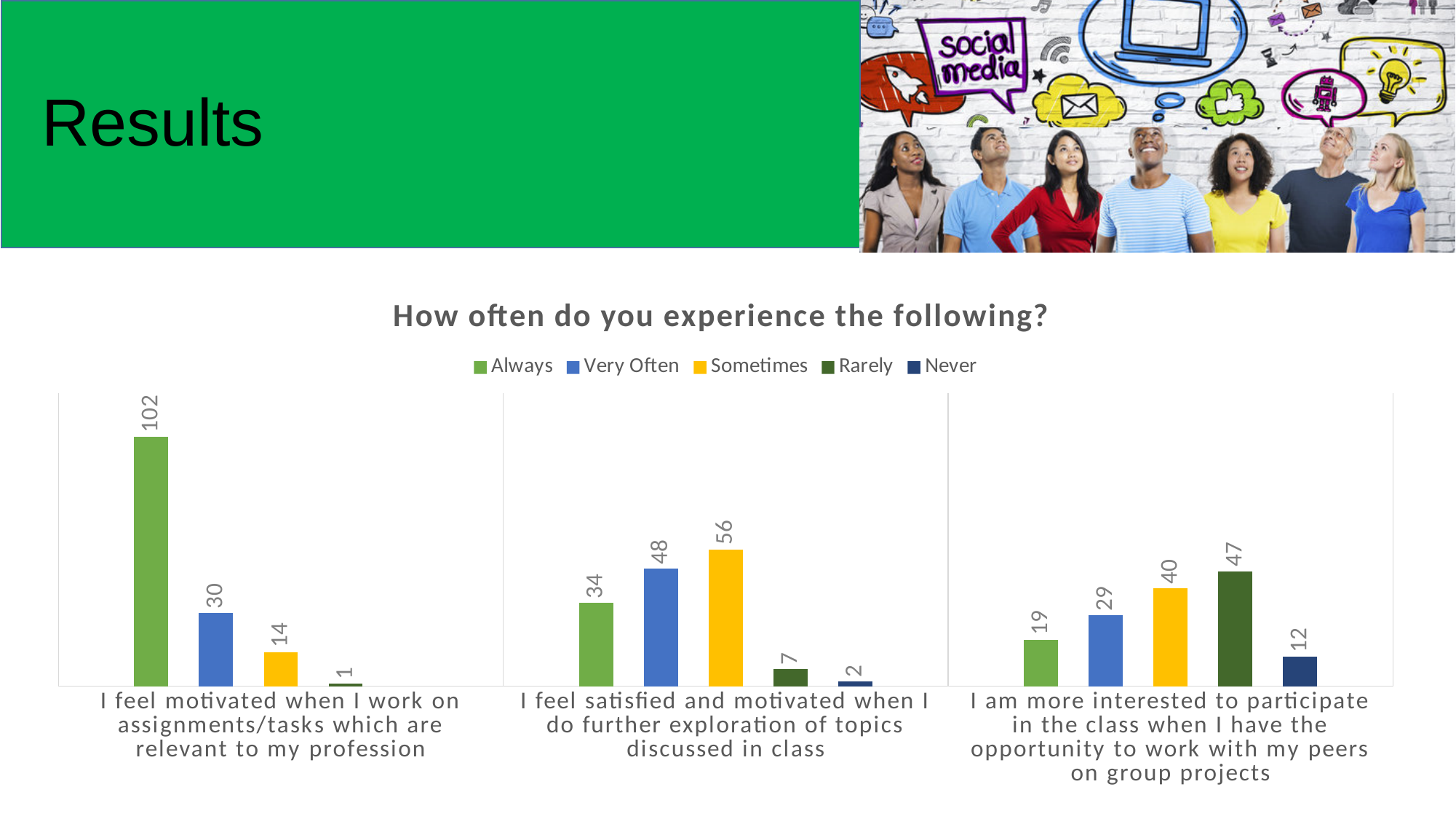
How many series does the legend list? 5 Which response has the lowest value for the statement "I feel motivated when I work on assignments/tasks which are relevant to my profession"? Rarely What kind of chart is shown on the slide? Bar chart What is the value for "Never" for the statement "I am more interested to participate in the class when I have the opportunity to work with my peers on group projects"? 12 How many statements (categories) are shown on the x axis of the chart? 3 What is the title of the chart? How often do you experience the following? For the statement "I am more interested to participate in the class when I have the opportunity to work with my peers on group projects", which is larger: "Sometimes" or "Very Often"? Sometimes What is the total of all five responses for the statement "I feel motivated when I work on assignments/tasks which are relevant to my profession"? 147 What is the value for "Always" for the statement "I feel motivated when I work on assignments/tasks which are relevant to my profession"? 102 Which response has the highest value for the statement "I am more interested to participate in the class when I have the opportunity to work with my peers on group projects"? Rarely What is the value for "Sometimes" for the statement "I feel satisfied and motivated when I do further exploration of topics discussed in class"? 56 What is the difference between the "Very Often" and "Always" values for the statement "I feel satisfied and motivated when I do further exploration of topics discussed in class"? 14